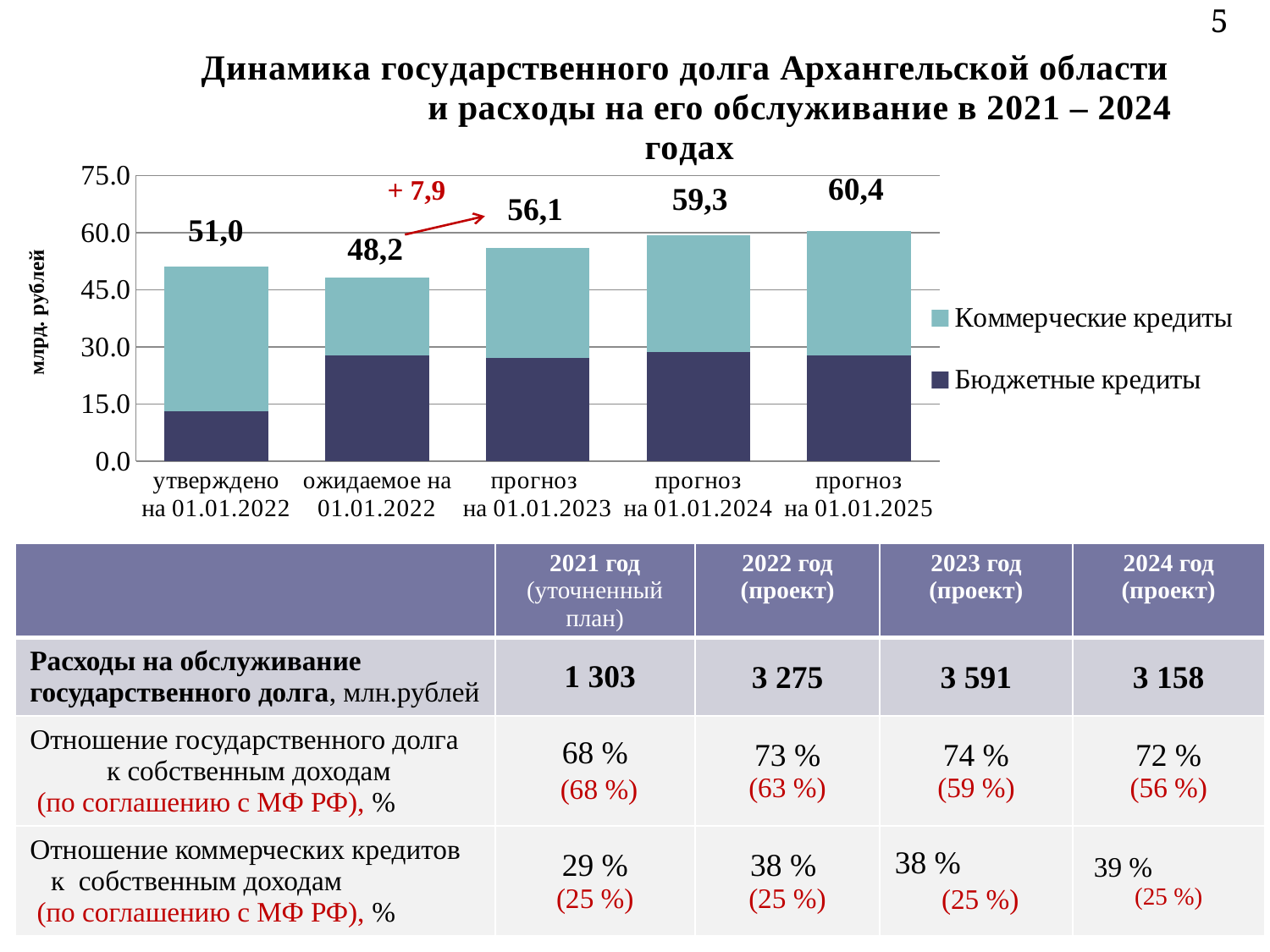
How many bars are plotted in the chart? 5 Which bar has the highest total state debt? прогноз на 01.01.2025 From 'ожидаемое на 01.01.2022' to 'прогноз на 01.01.2025', do the total values rise or fall? rise What is the total state debt shown for the bar labelled 'утверждено на 01.01.2022'? 51,0 Is the value of 'Бюджетные кредиты' for 'утверждено на 01.01.2022' greater or less than 15.0? less Which bar has the lowest total state debt? ожидаемое на 01.01.2022 What is the total state debt shown for 'прогноз на 01.01.2025'? 60,4 What type of chart is shown on the slide? stacked bar chart Which total is larger: 'прогноз на 01.01.2024' or 'прогноз на 01.01.2023'? прогноз на 01.01.2024 What is the total state debt shown for 'ожидаемое на 01.01.2022'? 48,2 How many series does the chart legend list? 2 By how much does the total for 'прогноз на 01.01.2023' exceed the total for 'ожидаемое на 01.01.2022'? 7,9